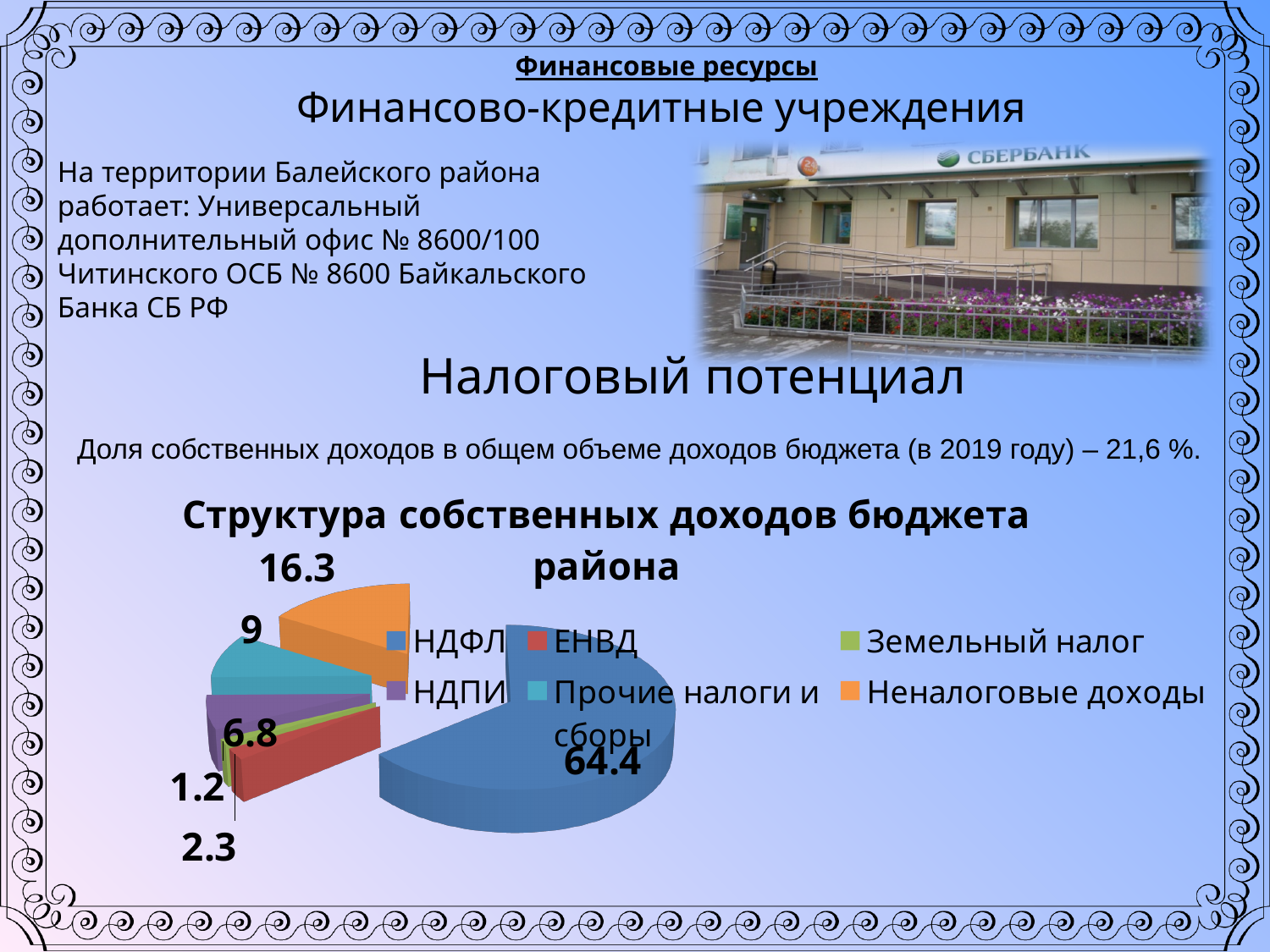
What kind of chart is shown on the slide? pie chart How many categories does the legend of the pie chart list? 6 What is the difference between the values for НДФЛ and Неналоговые доходы? 48.1 Which category has the largest slice in the pie chart? НДФЛ What is the value for Земельный налог in the pie chart? 1.2 Which category has the smallest slice in the pie chart? Земельный налог What is the value for НДПИ in the pie chart? 6.8 What is the value for Прочие налоги и сборы in the pie chart? 9 What is the value for НДФЛ in the pie chart? 64.4 What is the value for ЕНВД in the pie chart? 2.3 Which is larger, the value for ЕНВД or the value for НДПИ? НДПИ What is the value for Неналоговые доходы in the pie chart? 16.3